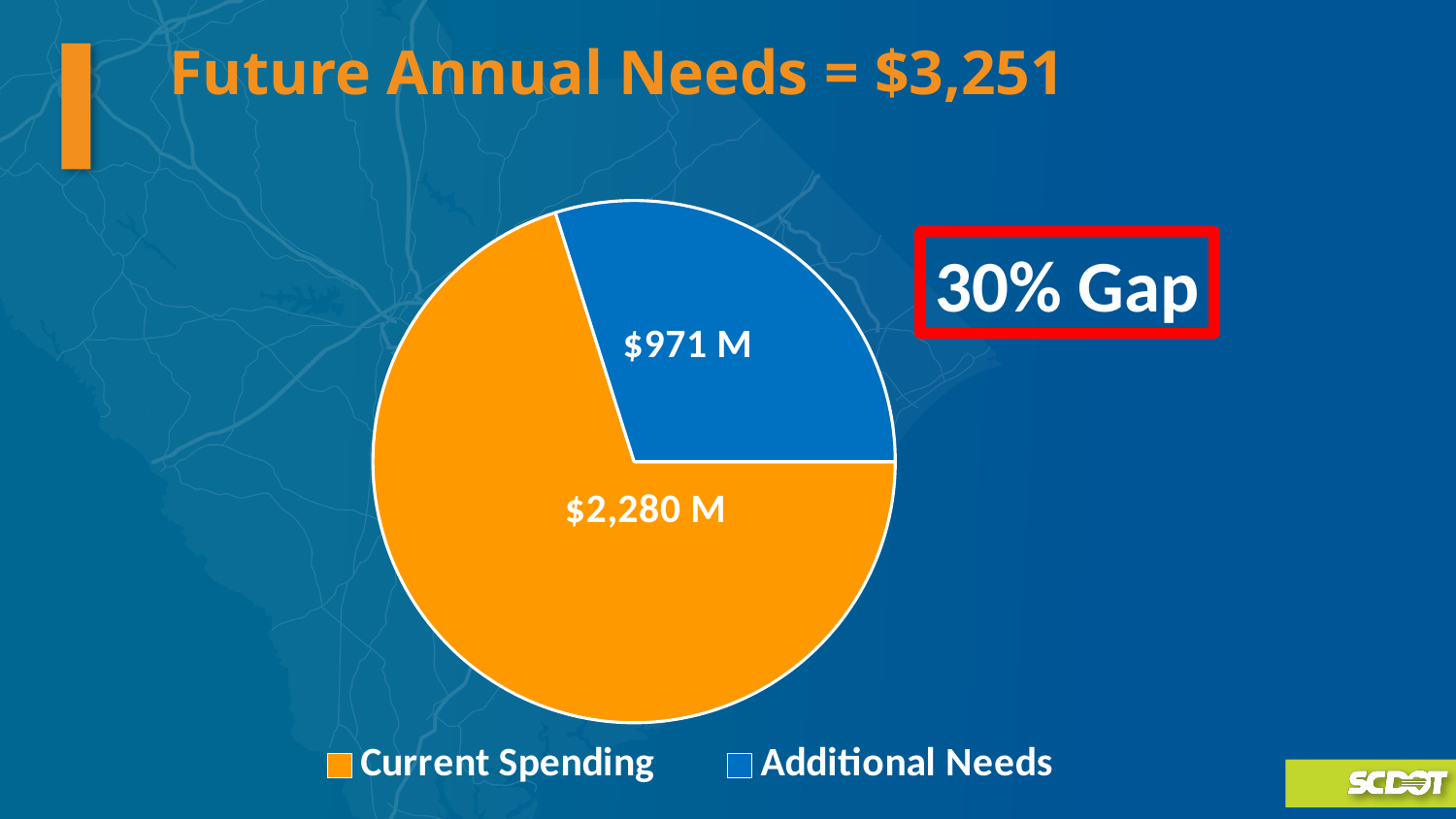
What colour is the Additional Needs slice? blue Which slice is the largest? Current Spending What is the title of the slide above the chart? Future Annual Needs = $3,251 How many slices does the pie chart have? 2 How many entries does the legend list? 2 Which is larger, Current Spending or Additional Needs? Current Spending What type of chart is shown on the slide? pie chart Which slice is the smallest? Additional Needs What is the value for Additional Needs? $971 M What is the difference between Current Spending and Additional Needs? $1,309 M What is the value for Current Spending? $2,280 M What is the total of the two slices? $3,251 M